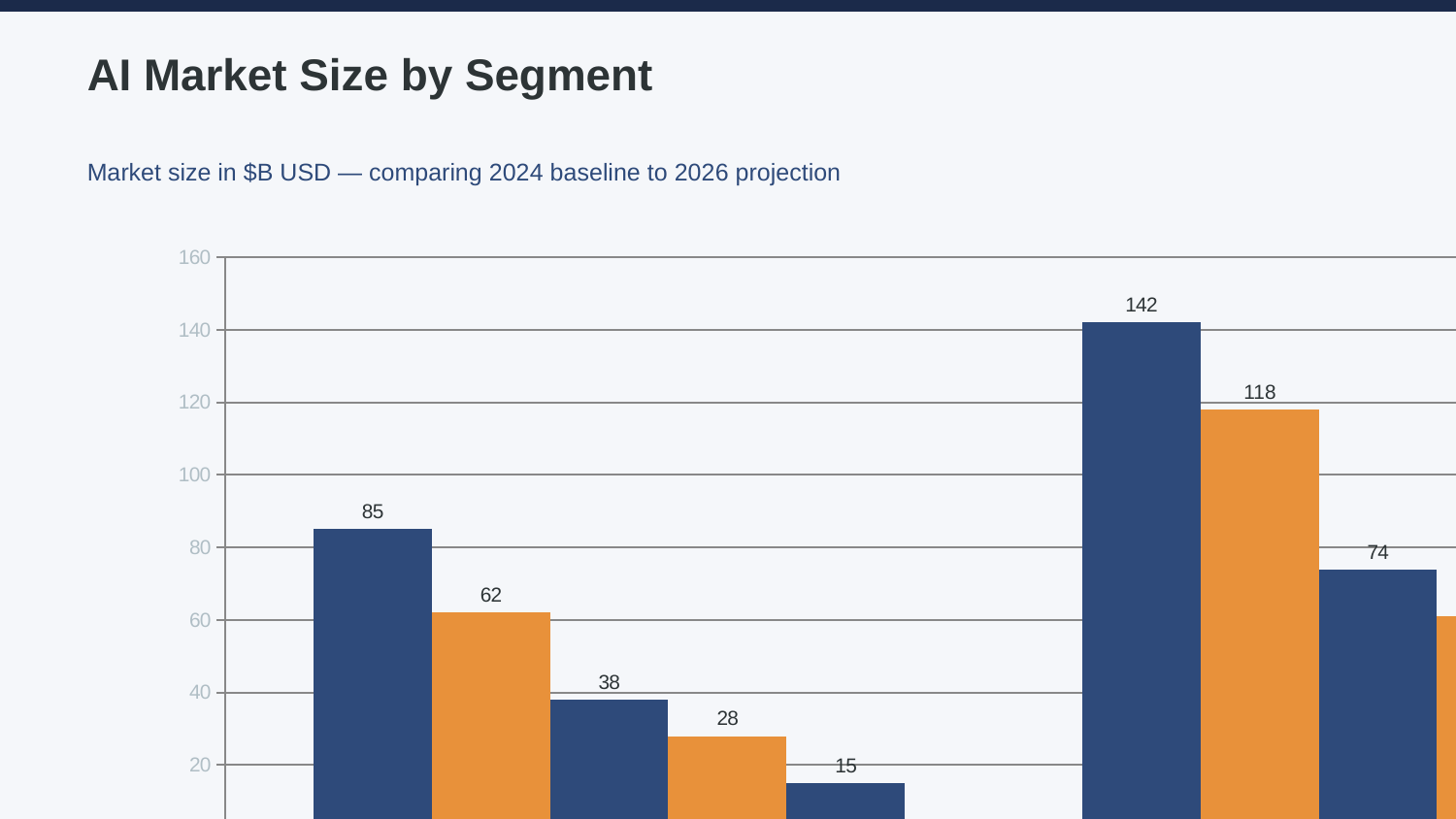
What is the highest value shown on the vertical axis? 160 How many bars on the chart have a visible data label? 8 What is the title of the chart on the slide? AI Market Size by Segment What is the highest data label shown on the chart? 142 What is the lowest data label shown on the chart? 15 Is the value of the tallest orange bar greater or less than 120? less Is the value of the tallest blue bar greater or less than 140? greater What kind of chart is shown on the slide? bar chart What is the value of the first blue bar on the left of the chart? 85 What is the difference between the bars labelled 142 and 118? 24 What is the difference between the bars labelled 85 and 62? 23 Which is larger, the tallest blue bar or the tallest orange bar? the tallest blue bar (142)